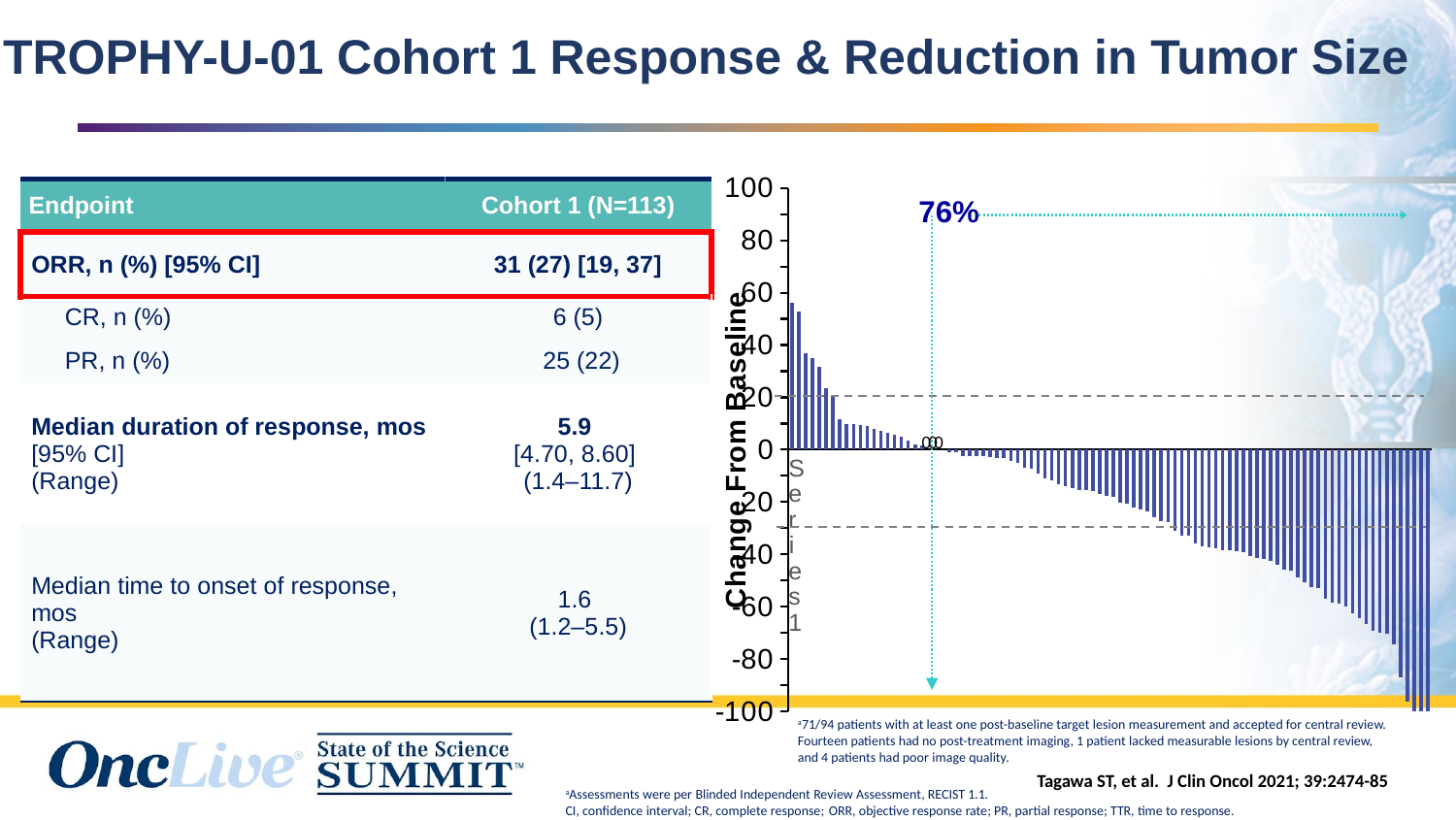
What is the lowest value shown on the vertical axis of the bar chart? -100 What percentage is annotated in the upper part of the bar chart? 76% Is the value of the lowest bar in the chart greater or less than -80? less Which bar is larger in the chart, the leftmost bar or the rightmost bar? the leftmost bar What is the highest value shown on the vertical axis of the bar chart? 100 What kind of chart is shown on the right side of the slide? bar chart What is the label of the vertical axis of the bar chart? Change From Baseline Is the value of the tallest positive bar in the chart greater or less than 40? greater Is the value of the leftmost bar in the chart greater or less than 20? greater Do the bar values rise or fall moving from left to right along the x axis of the bar chart? fall